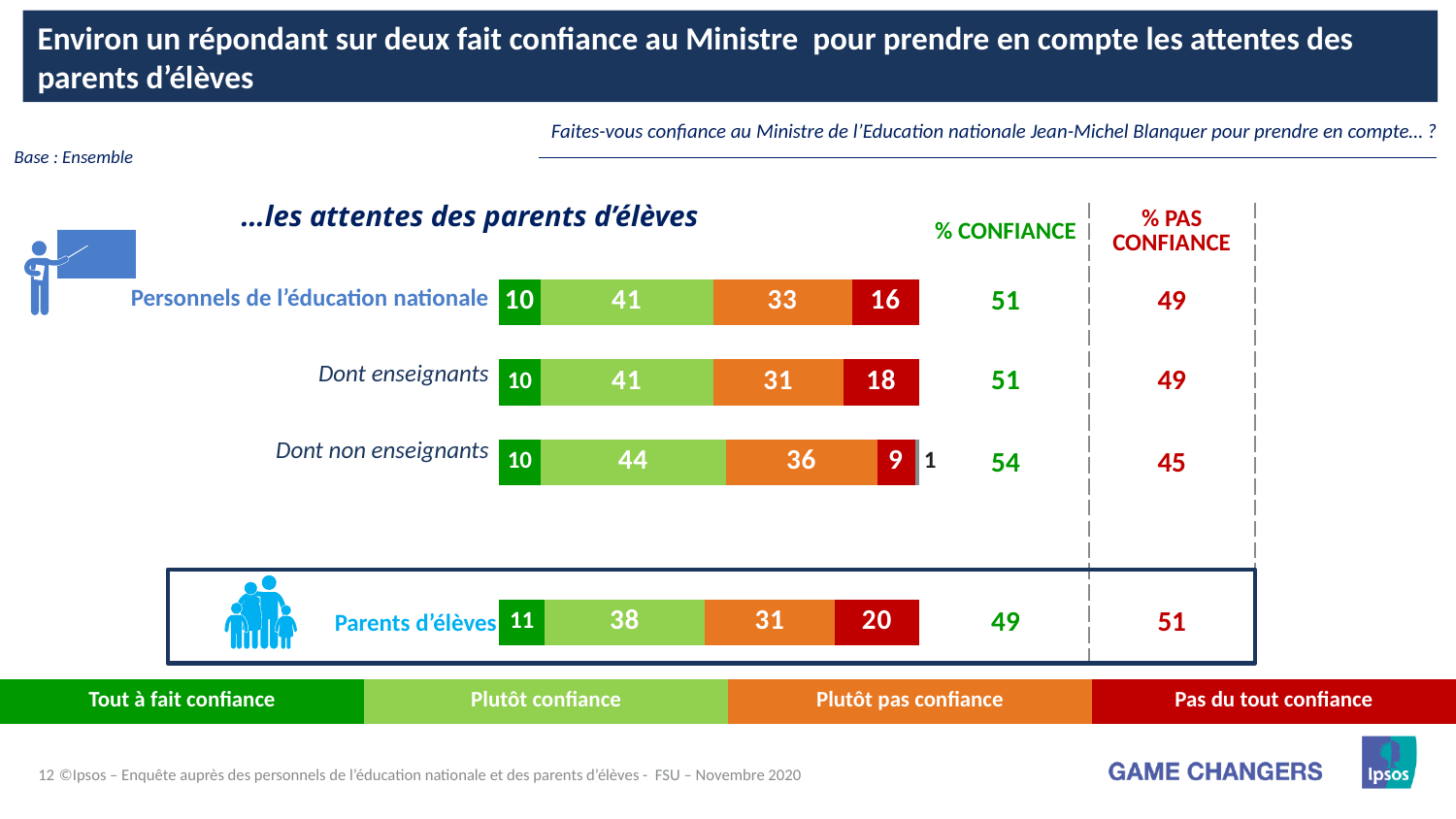
What is the value for "Plutôt pas confiance" for "Dont non enseignants"? 36 Which category has the lowest value for "Pas du tout confiance"? Dont non enseignants What is the value for "Tout à fait confiance" for "Parents d'élèves"? 11 How many categories are shown in the bar chart? 4 What is the "% CONFIANCE" value shown for "Dont non enseignants"? 54 What is the value for "Pas du tout confiance" for "Dont enseignants"? 18 What is the difference between the "Plutôt confiance" values for "Dont non enseignants" and "Parents d'élèves"? 6 What kind of chart is shown on the slide? Stacked bar chart Which category has the highest value for "Pas du tout confiance"? Parents d'élèves Which is larger: the "Plutôt pas confiance" value for "Personnels de l'éducation nationale" or for "Dont enseignants"? Personnels de l'éducation nationale How many series does the legend list? 4 What is the value for "Plutôt confiance" for "Personnels de l'éducation nationale"? 41